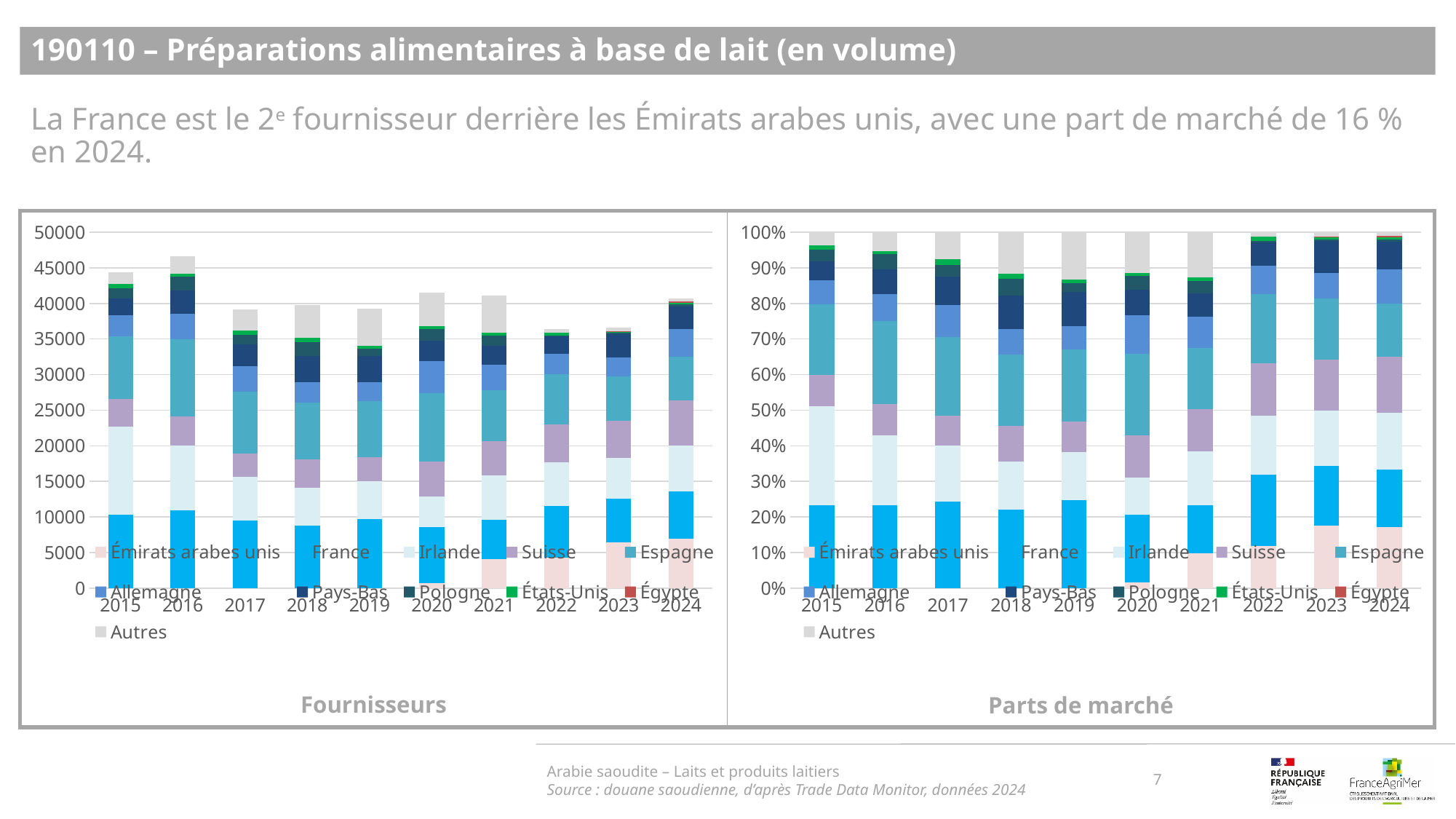
In the 'Fournisseurs' chart, which total is larger, 2016 or 2017? 2016 What is the title of the chart on the right of the slide? Parts de marché In the 'Fournisseurs' chart, which year has the highest total bar? 2016 What kind of chart is the 'Fournisseurs' chart on the left? stacked bar chart In the 'Fournisseurs' chart, is the total for 2022 greater or less than 40000? less How many series does the legend of the 'Fournisseurs' chart list? 11 In the 'Fournisseurs' chart, is the total for 2020 greater or less than 40000? greater In the 'Parts de marché' chart, what colour represents the 'Autres' series? grey In the 'Fournisseurs' chart, is the total for 2016 greater or less than 45000? greater How many years are shown on the x axis of the 'Parts de marché' chart? 10 In the 'Parts de marché' chart, is the share of France larger in 2015 or in 2024? 2015